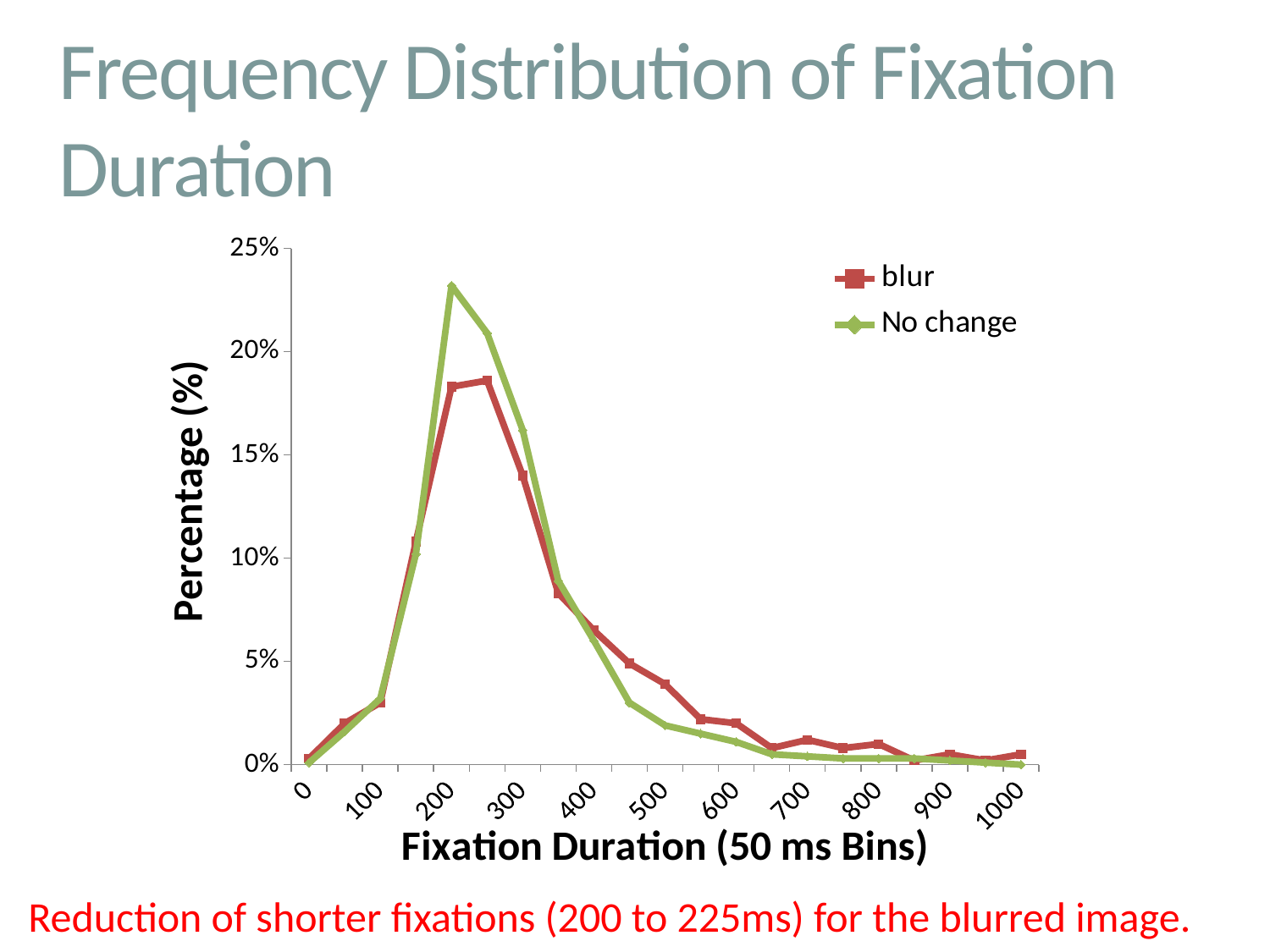
What are the two series named in the legend? blur and No change Is the value for the blur series at a fixation duration of 200 greater or less than 20%? less How many series does the legend list? 2 Is the value for the blur series at a fixation duration of 300 greater or less than 15%? less At a fixation duration of 200, which series has the higher value, blur or No change? No change What is the title of the vertical axis? Percentage (%) Is the value for the blur series at a fixation duration of 250 greater or less than 15%? greater What kind of chart is shown on the slide? line chart Which series reaches the highest peak value on the chart? No change At a fixation duration of 500, which series has the higher value, blur or No change? blur From a fixation duration of 300 to 1000, do the values for the No change series rise or fall? fall